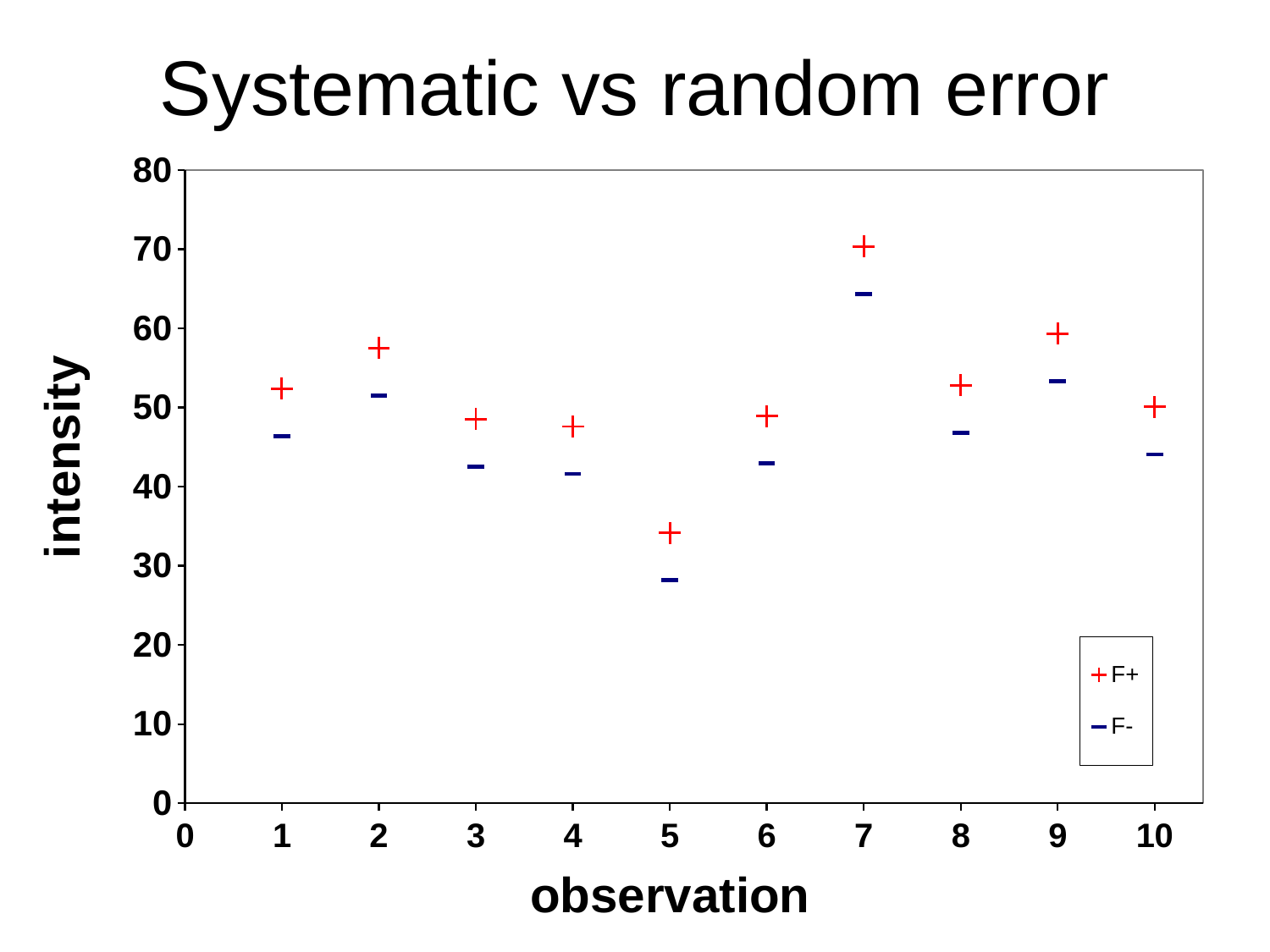
Is the F- value at observation 4 greater or less than 50? less Is the F+ value at observation 7 greater or less than 60? greater Is the F+ value at observation 2 greater or less than 50? greater How many series does the legend list? 2 At which observation does the F+ series reach its highest intensity? 7 At observation 3, which series has the larger intensity, F+ or F-? F+ At which observation does the F- series reach its highest intensity? 7 What is the title of the chart? Systematic vs random error What kind of chart is shown on the slide? scatter chart At which observation does the F- series have its lowest intensity? 5 How many observations are plotted for each series? 10